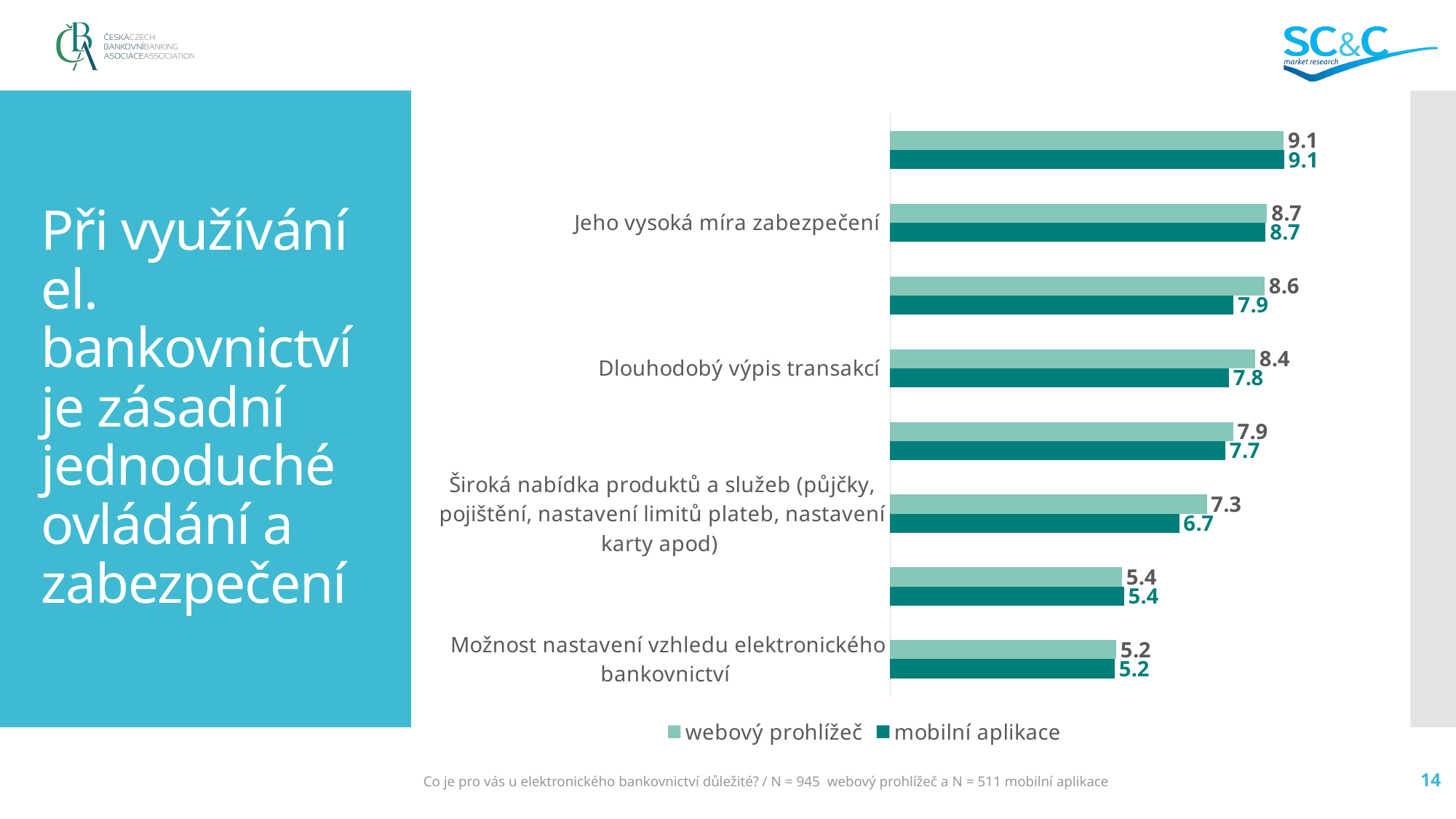
What is the value for webový prohlížeč for 'Jeho vysoká míra zabezpečení'? 8.7 For 'Dlouhodobý výpis transakcí', which series has the larger value, webový prohlížeč or mobilní aplikace? webový prohlížeč What is the difference between the webový prohlížeč and mobilní aplikace values for 'Dlouhodobý výpis transakcí'? 0.6 How many categories (pairs of bars) are plotted in the chart? 8 What is the value for mobilní aplikace for 'Dlouhodobý výpis transakcí'? 7.8 What kind of chart is shown on the slide? bar chart What is the value for mobilní aplikace for 'Možnost nastavení vzhledu elektronického bankovnictví'? 5.2 How many series does the legend list? 2 What are the two series named in the legend? webový prohlížeč and mobilní aplikace Which category has the lowest value for mobilní aplikace? Možnost nastavení vzhledu elektronického bankovnictví What is the value for webový prohlížeč for 'Široká nabídka produktů a služeb (půjčky, pojištění, nastavení limitů plateb, nastavení karty apod)'? 7.3 What is the difference between the webový prohlížeč and mobilní aplikace values for 'Široká nabídka produktů a služeb'? 0.6